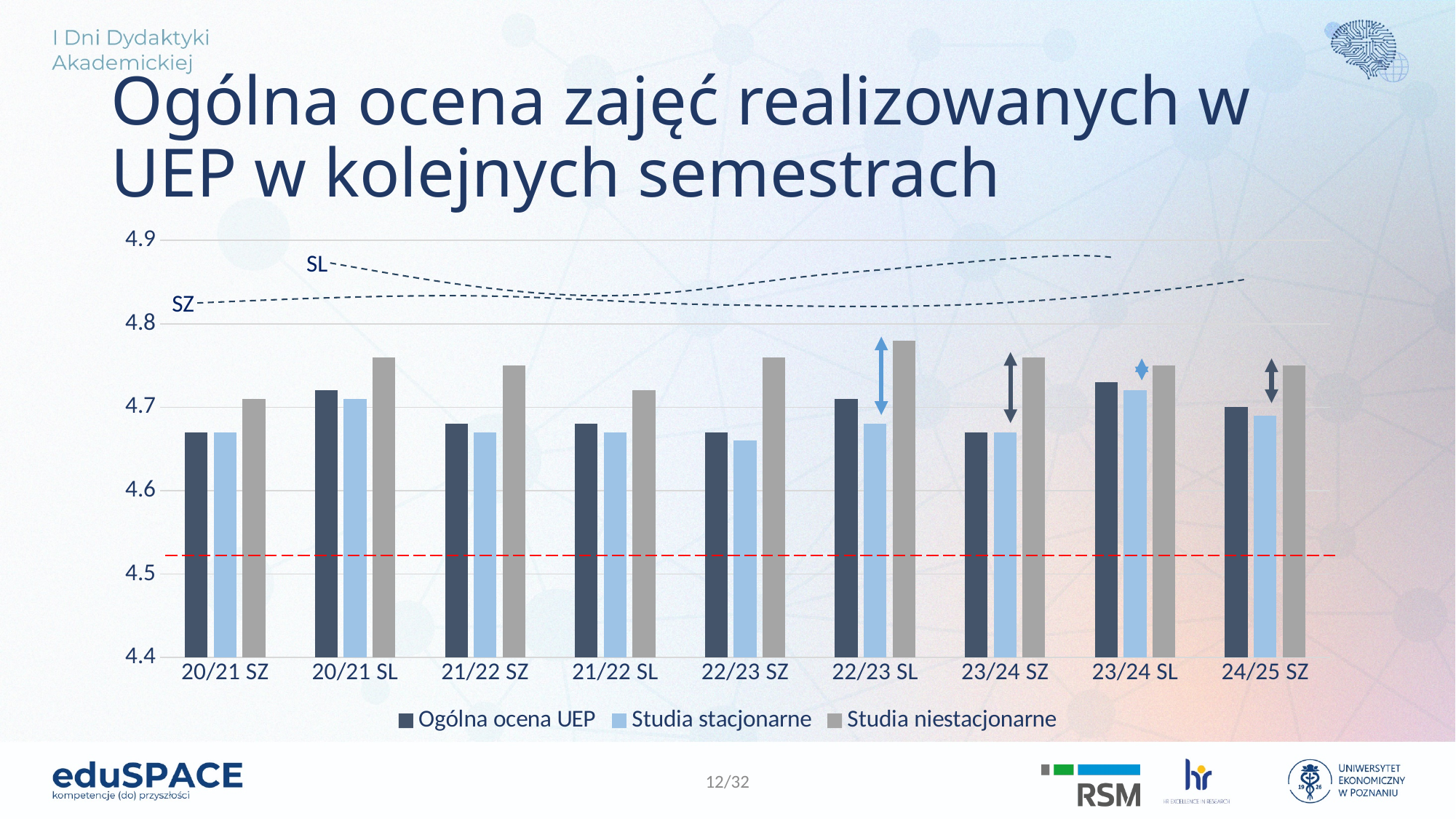
How many semester categories are shown on the x axis? 9 What is the title of the chart on the slide? Ogólna ocena zajęć realizowanych w UEP w kolejnych semestrach Is the Ogólna ocena UEP value for 20/21 SZ greater or less than 4.6? greater For 23/24 SZ, which is larger: Studia niestacjonarne or Ogólna ocena UEP? Studia niestacjonarne What kind of chart is shown on the slide? bar chart Is the Studia niestacjonarne value for 22/23 SL greater or less than 4.7? greater How many series does the legend list? 3 Which series is shown in light blue according to the legend? Studia stacjonarne Is the Studia stacjonarne value for 22/23 SZ greater or less than 4.7? less In which semester is the Studia niestacjonarne value the highest? 22/23 SL For 22/23 SL, which is larger: Studia stacjonarne or Studia niestacjonarne? Studia niestacjonarne